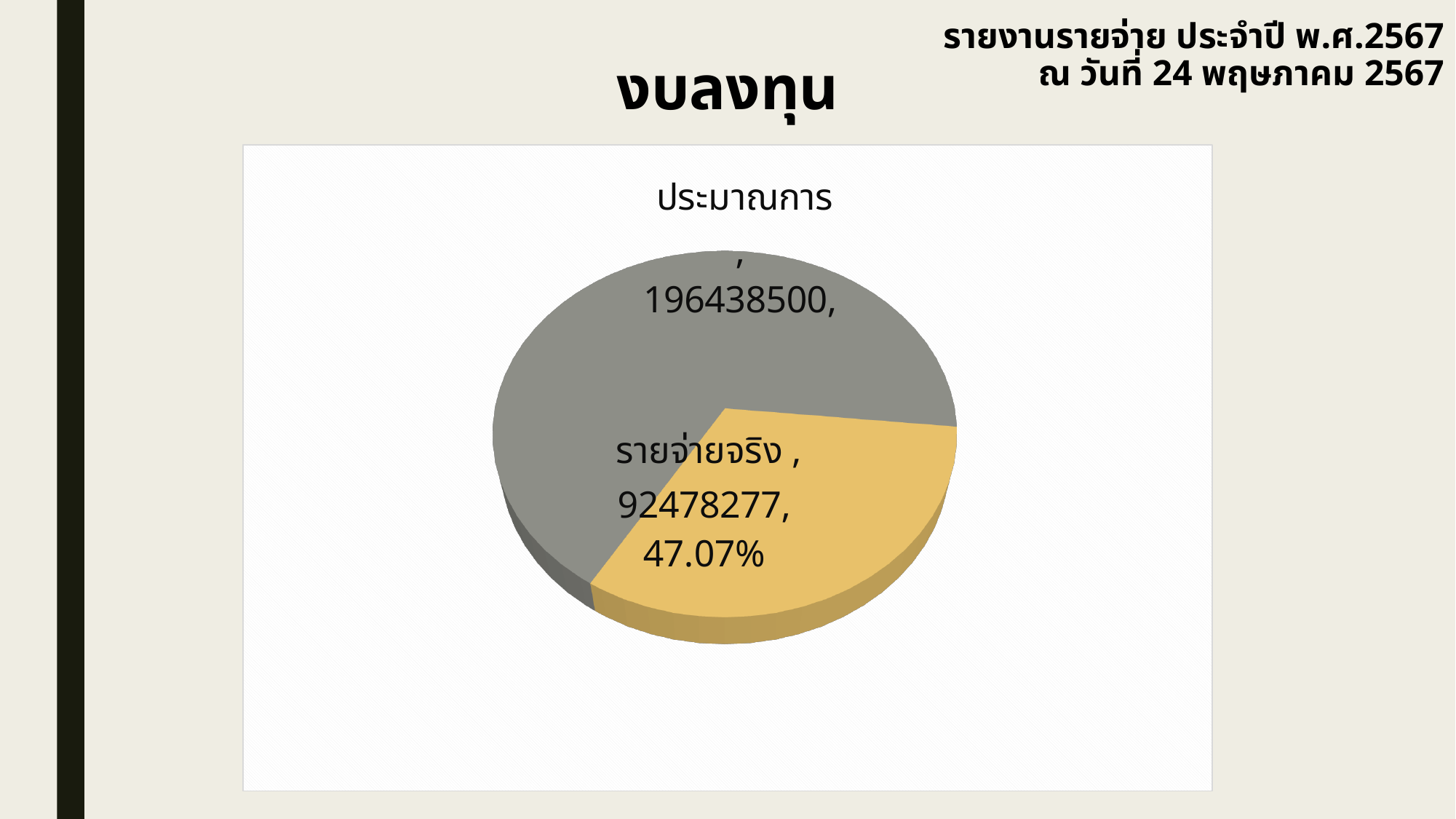
Which slice of the pie chart has the largest value? ประมาณการ How many slices does the pie chart have? 2 What is the difference between the value for ประมาณการ and the value for รายจ่ายจริง? 103960223 What kind of chart is shown on the slide? pie chart What colour is the รายจ่ายจริง slice in the pie chart? yellow What percentage is printed on the รายจ่ายจริง slice? 47.07% What is the value shown for รายจ่ายจริง in the pie chart? 92478277 Which slice of the pie chart has the smallest value? รายจ่ายจริง What is the title of the slide above the pie chart? งบลงทุน Which is larger, the value for ประมาณการ or the value for รายจ่ายจริง? ประมาณการ What is the value shown for ประมาณการ in the pie chart? 196438500